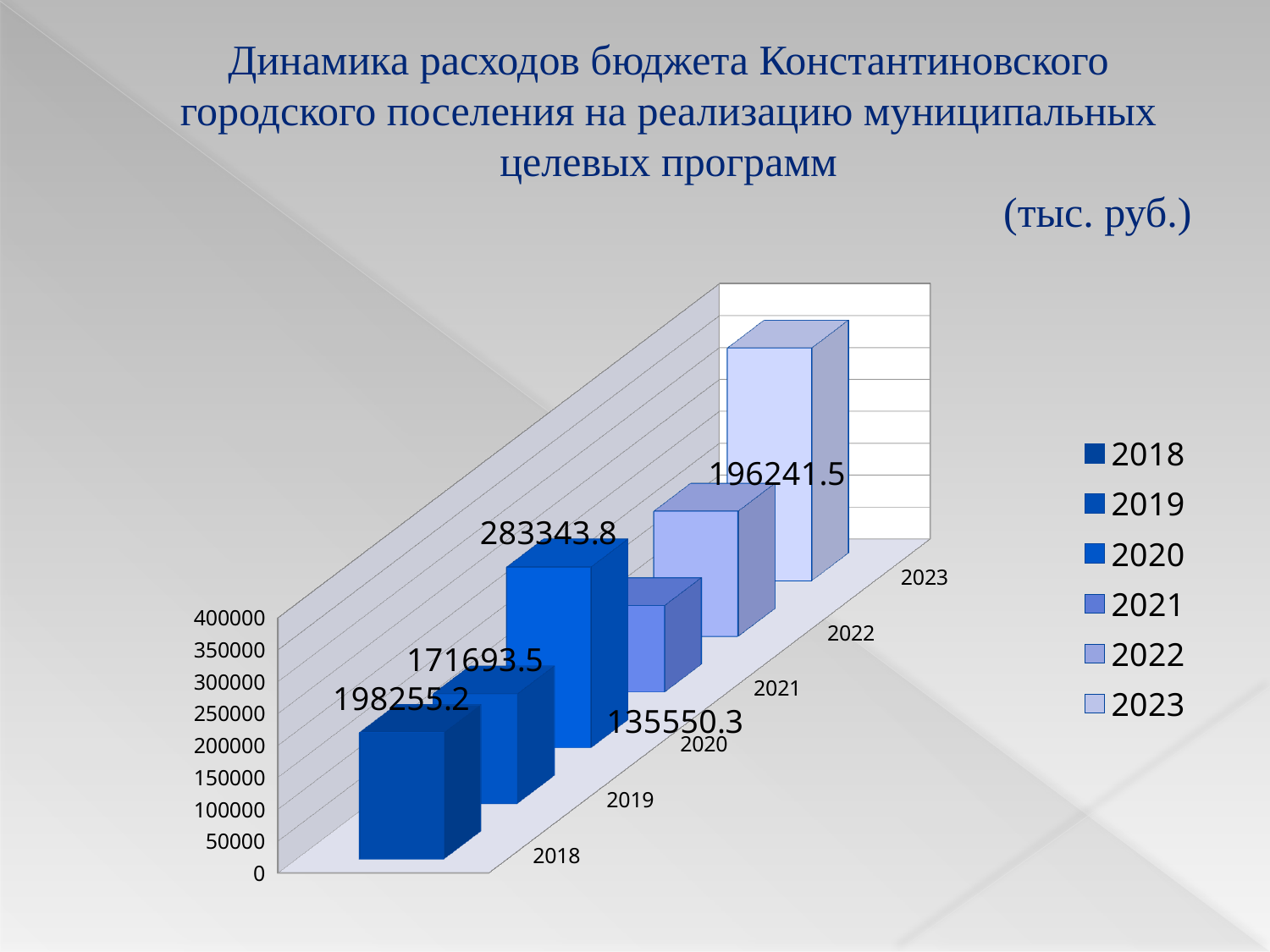
Which is larger, the value for 2018 or the value for 2022? 2018 What is the difference between the values for 2020 and 2019? 111650.3 How many years are shown on the chart? 6 What is the value for 2020? 283343.8 What is the value for 2018? 198255.2 What is the difference between the values for 2018 and 2021? 62704.9 Which year has the lowest value? 2021 What is the value for 2021? 135550.3 What is the value for 2019? 171693.5 What is the value for 2022? 196241.5 What kind of chart is shown on the slide? bar chart How many entries does the legend list? 6